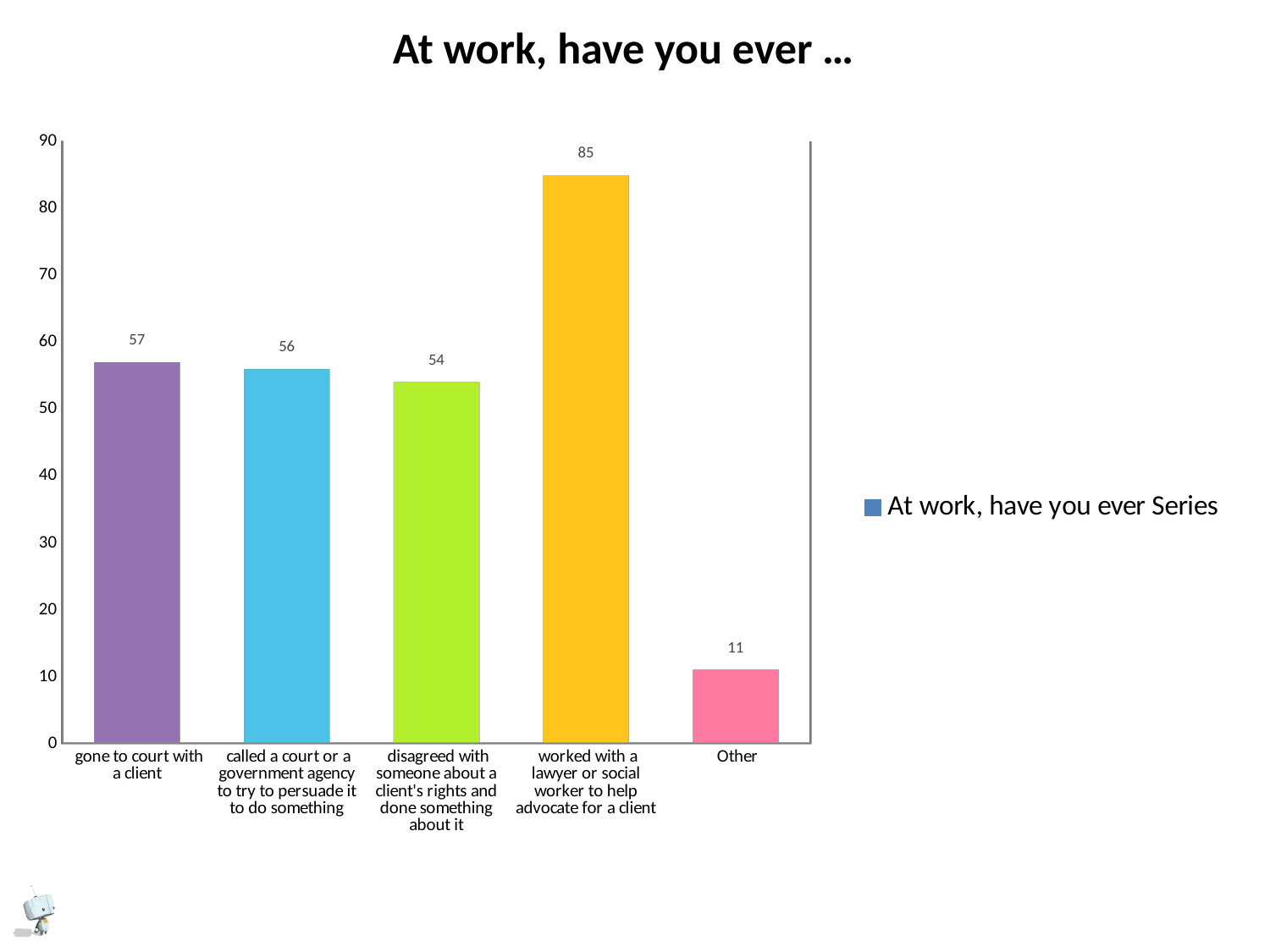
What is the value for "gone to court with a client"? 57 Which category has the highest value? worked with a lawyer or social worker to help advocate for a client What is the value for "Other"? 11 What is the value for "disagreed with someone about a client's rights and done something about it"? 54 What kind of chart is shown on the slide? bar chart What is the difference between the values for "called a court or a government agency to try to persuade it to do something" and "Other"? 45 What is the title of the chart? At work, have you ever … Which is larger: the value for "gone to court with a client" or the value for "disagreed with someone about a client's rights and done something about it"? gone to court with a client How many categories are shown on the x axis? 5 What is the difference between the values for "worked with a lawyer or social worker to help advocate for a client" and "gone to court with a client"? 28 What is the value for "worked with a lawyer or social worker to help advocate for a client"? 85 Which category has the lowest value? Other